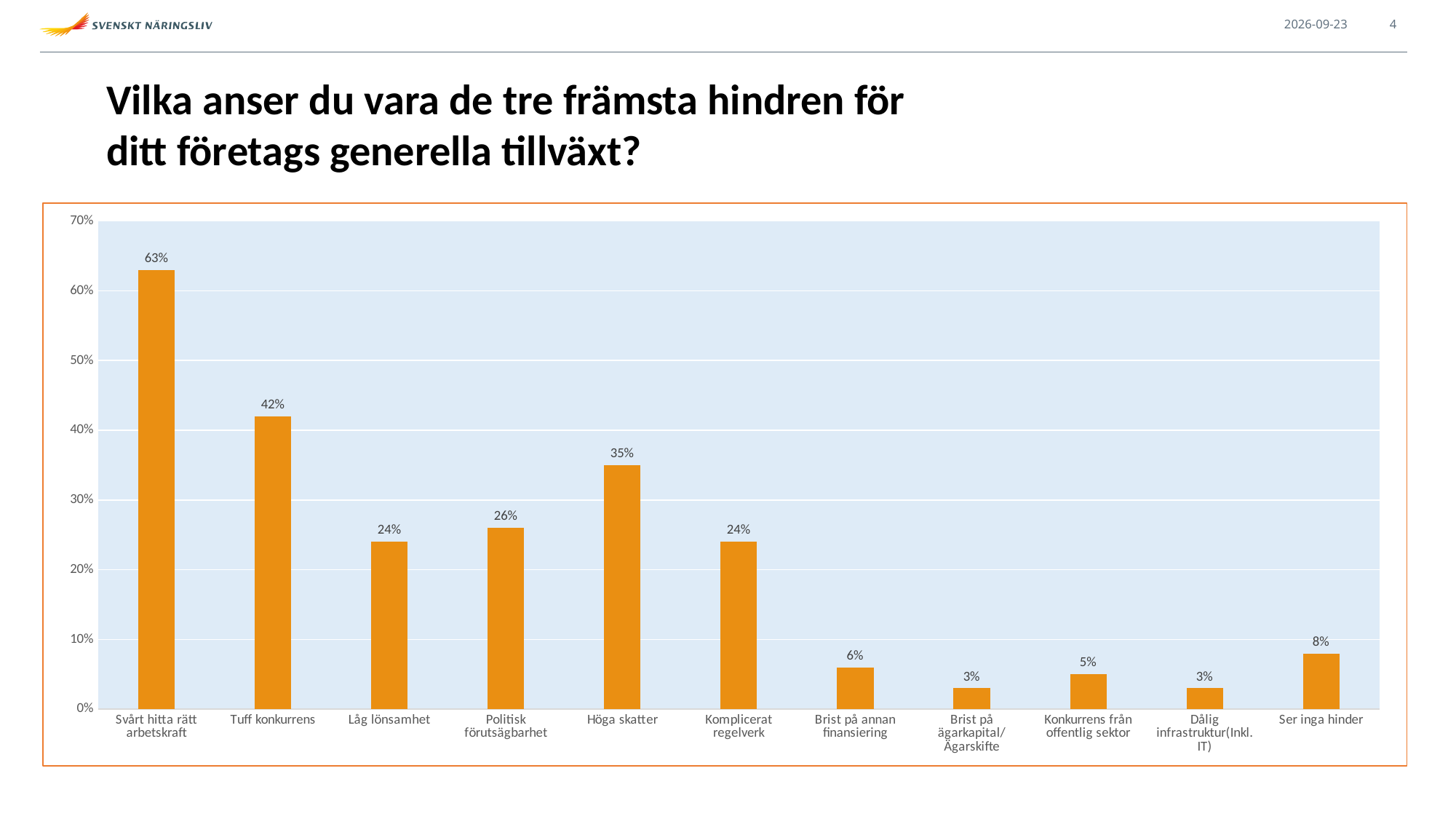
What is the value shown for "Höga skatter"? 35% How many categories are shown on the x axis of the chart? 11 Is the value for "Politisk förutsägbarhet" greater or less than 30%? less Which is larger, the value for "Brist på annan finansiering" or the value for "Konkurrens från offentlig sektor"? Brist på annan finansiering Which is larger, the value for "Tuff konkurrens" or the value for "Höga skatter"? Tuff konkurrens What type of chart is shown on the slide? Bar chart What is the difference between the values for "Svårt hitta rätt arbetskraft" and "Tuff konkurrens"? 21% Which category has the highest value in the chart? Svårt hitta rätt arbetskraft What is the value shown for "Ser inga hinder"? 8% What is the difference between the values for "Höga skatter" and "Komplicerat regelverk"? 11% What is the value shown for "Politisk förutsägbarhet"? 26% What percentage of respondents chose "Svårt hitta rätt arbetskraft"? 63%